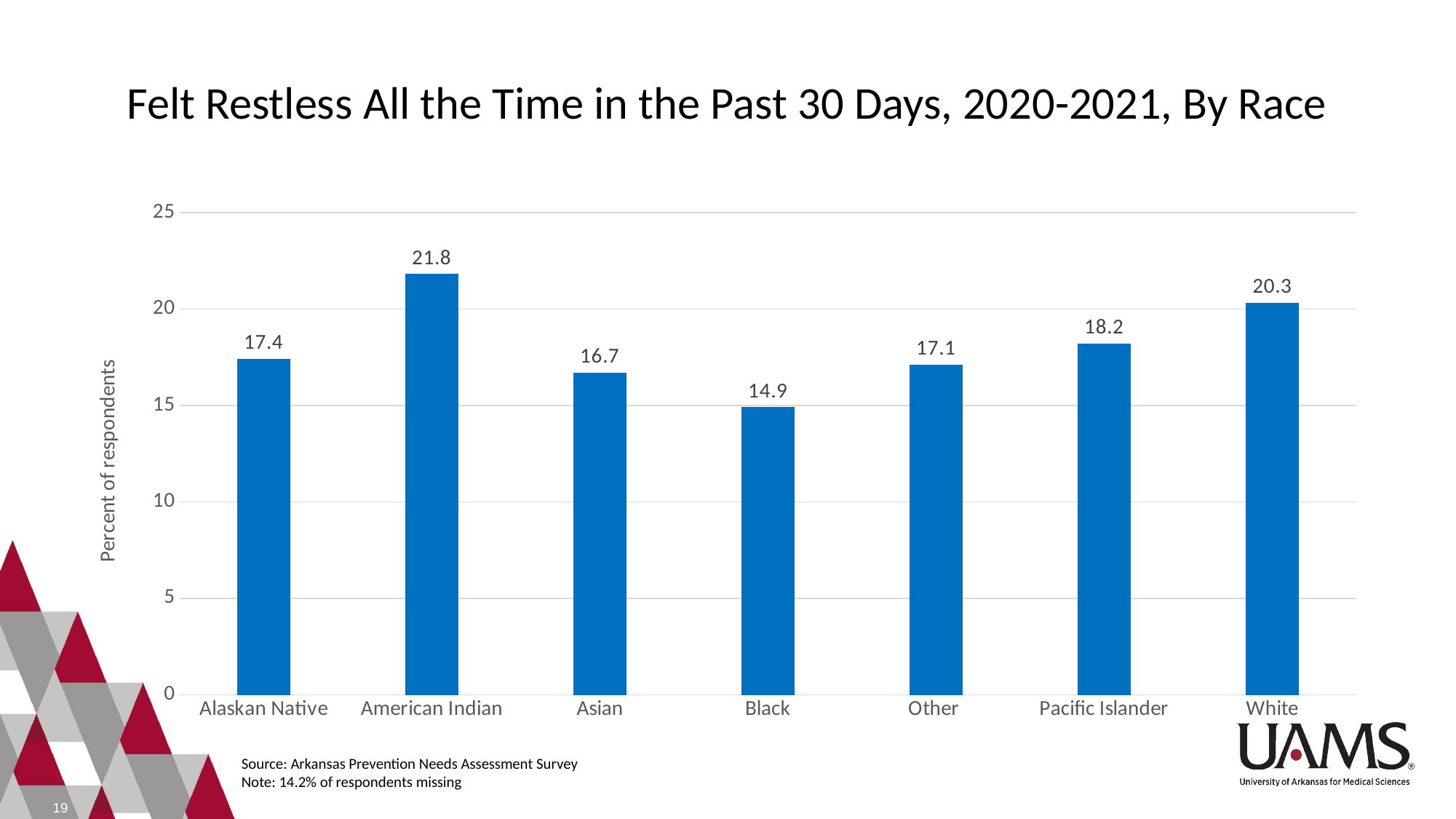
What is the value for Pacific Islander? 18.2 Which race category has the highest value? American Indian What is the label of the vertical axis? Percent of respondents Which is larger, the value for White or the value for Pacific Islander? White What is the difference between the values for White and Alaskan Native? 2.9 Which race category has the lowest value? Black Is the value for Asian greater or less than 15? greater How many race categories are shown on the chart? 7 What is the difference between the values for American Indian and Black? 6.9 What is the value for Black? 14.9 What is the value for American Indian? 21.8 What kind of chart is shown on the slide? Bar chart